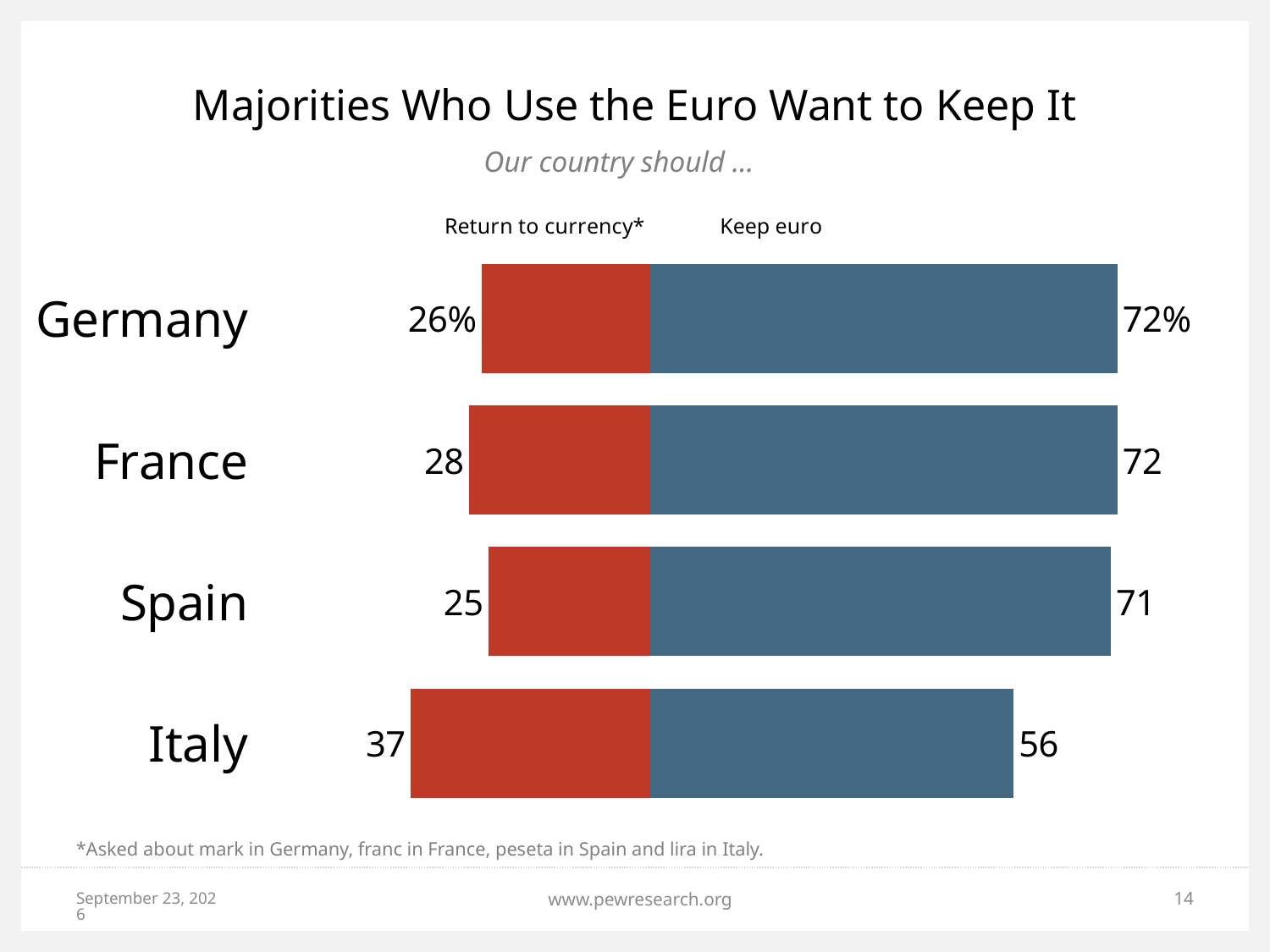
Which country has the lowest value for Return to currency? Spain What kind of chart is shown on the slide? Bar chart What percentage of respondents in Germany say their country should keep the euro? 72% What is the difference between the Keep euro and Return to currency values for Italy? 19 What is the value for Spain in the Keep euro series? 71 Which country has the highest value for Return to currency? Italy How many series does the chart show? 2 Is the Keep euro value larger for France or for Italy? France How many countries are shown in the chart? 4 What is the title of the chart? Majorities Who Use the Euro Want to Keep It Which country has the lowest value for Keep euro? Italy What is the value for Italy in the Return to currency series? 37